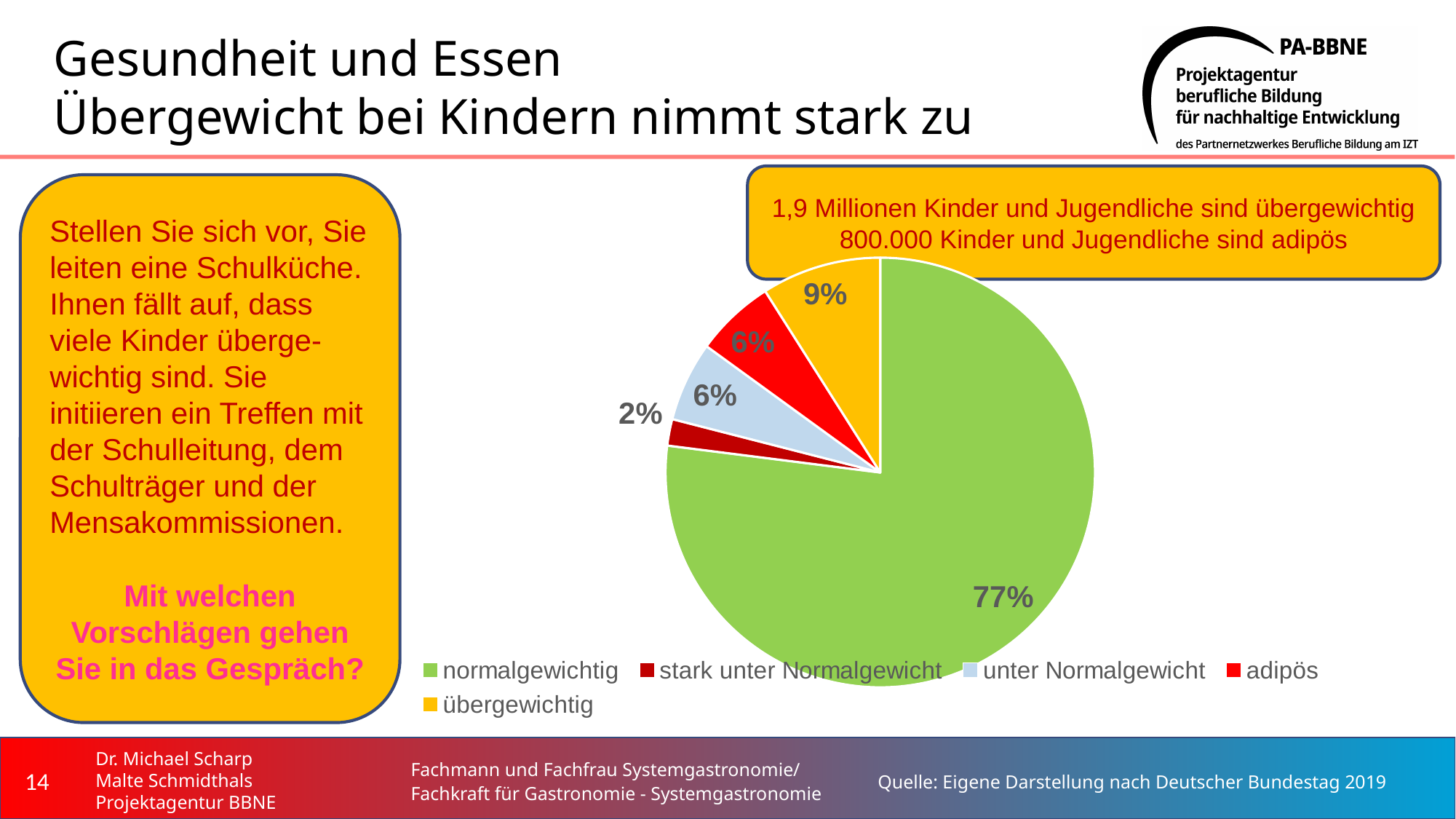
Which is larger, the slice for übergewichtig or the slice for stark unter Normalgewicht? übergewichtig What percentage is shown for adipös? 6% What kind of chart is shown on the slide? pie chart What share of the pie is labelled normalgewichtig? 77% What percentage is shown for übergewichtig? 9% How many categories does the legend list? 5 What colour is the slice for normalgewichtig? green Which category has the largest slice of the pie? normalgewichtig What percentage is shown for unter Normalgewicht? 6% What is the difference in percentage points between übergewichtig and adipös? 3 Which category has the smallest slice of the pie? stark unter Normalgewicht What percentage is shown for stark unter Normalgewicht? 2%